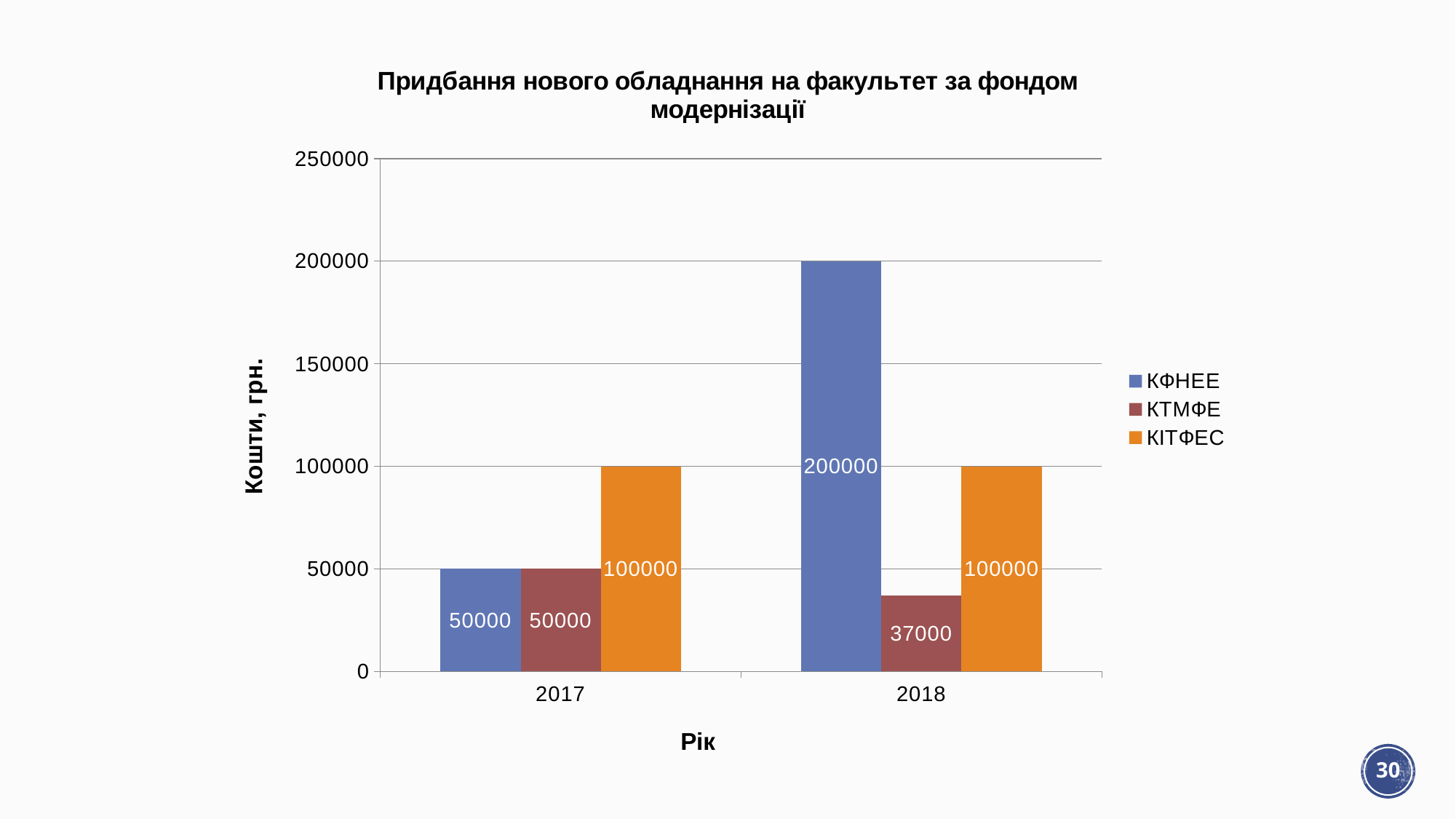
What kind of chart is this? Bar chart Which series has the highest value in 2018? КФНЕЕ What is the difference between the КФНЕЕ values for 2018 and 2017? 150000 What is the value for КІТФЕС in 2018? 100000 Which series has the lowest value in 2018? КТМФЕ What is the value for КТМФЕ in 2018? 37000 What is the label of the y axis? Кошти, грн. How many years are shown on the x axis? 2 What is the value for КТМФЕ in 2017? 50000 Which is larger: КТМФЕ in 2017 or КТМФЕ in 2018? КТМФЕ in 2017 What is the value for КФНЕЕ in 2018? 200000 How many series does the legend list? 3